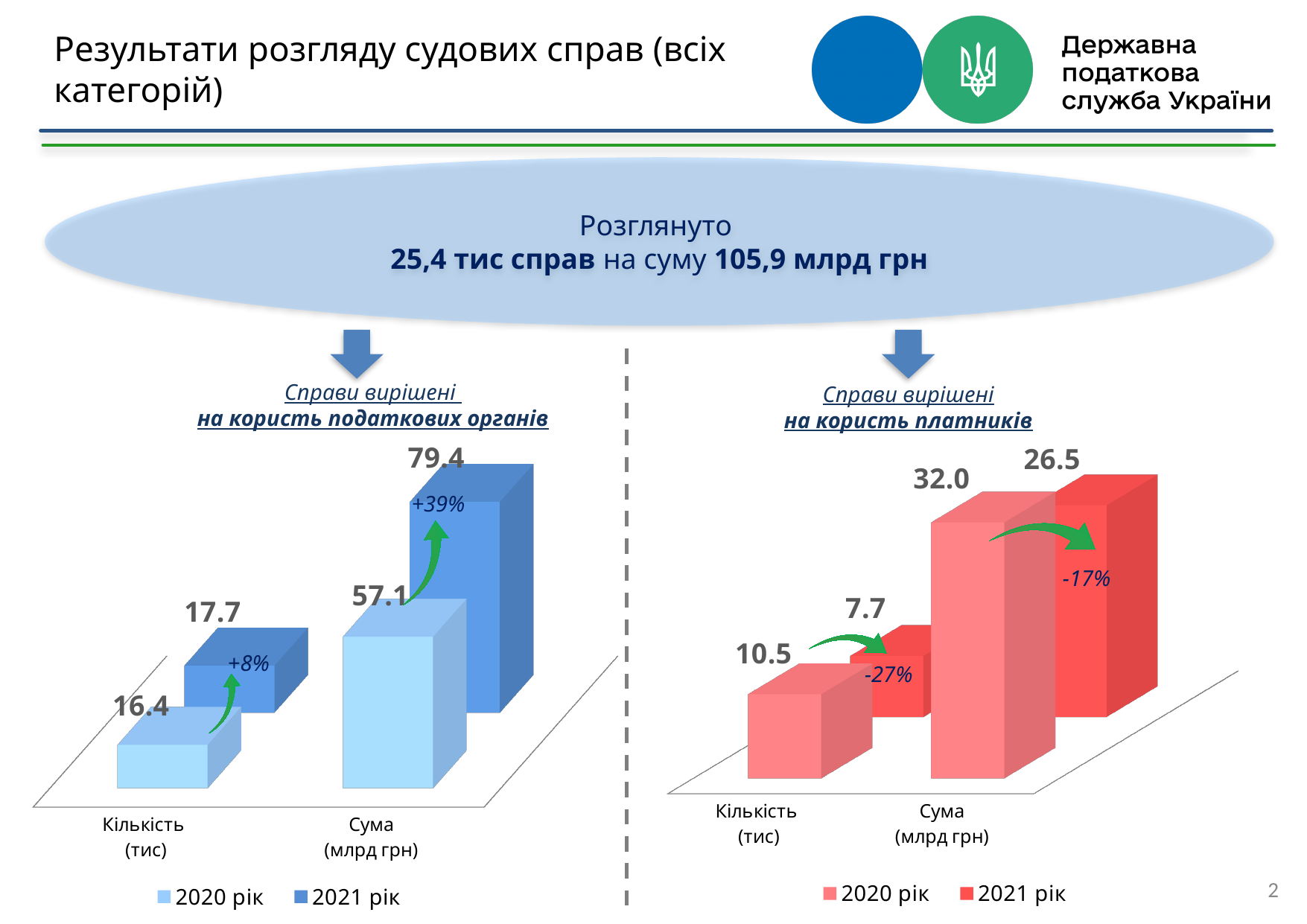
How many categories are shown on the x axis of the right chart? 2 In the right chart, which is larger for Сума (млрд грн): 2020 рік or 2021 рік? 2020 рік In the left chart, which is larger for Кількість (тис): 2020 рік or 2021 рік? 2021 рік What percentage change is labelled on the Сума bars in the right chart? -17% How many series does the legend of the left chart list? 2 In the right chart (Справи вирішені на користь платників), what is the value for Сума (млрд грн) in 2020 рік? 32.0 In the left chart (Справи вирішені на користь податкових органів), what is the value for Сума (млрд грн) in 2021 рік? 79.4 In the right chart (Справи вирішені на користь платників), what is the value for Кількість (тис) in 2021 рік? 7.7 In the left chart, what is the difference between the Сума (млрд грн) values for 2021 рік and 2020 рік? 22.3 What kind of chart is the right chart (Справи вирішені на користь платників)? Bar chart In the right chart, what is the difference between the Кількість (тис) values for 2020 рік and 2021 рік? 2.8 In the left chart (Справи вирішені на користь податкових органів), what is the value for Кількість (тис) in 2020 рік? 16.4